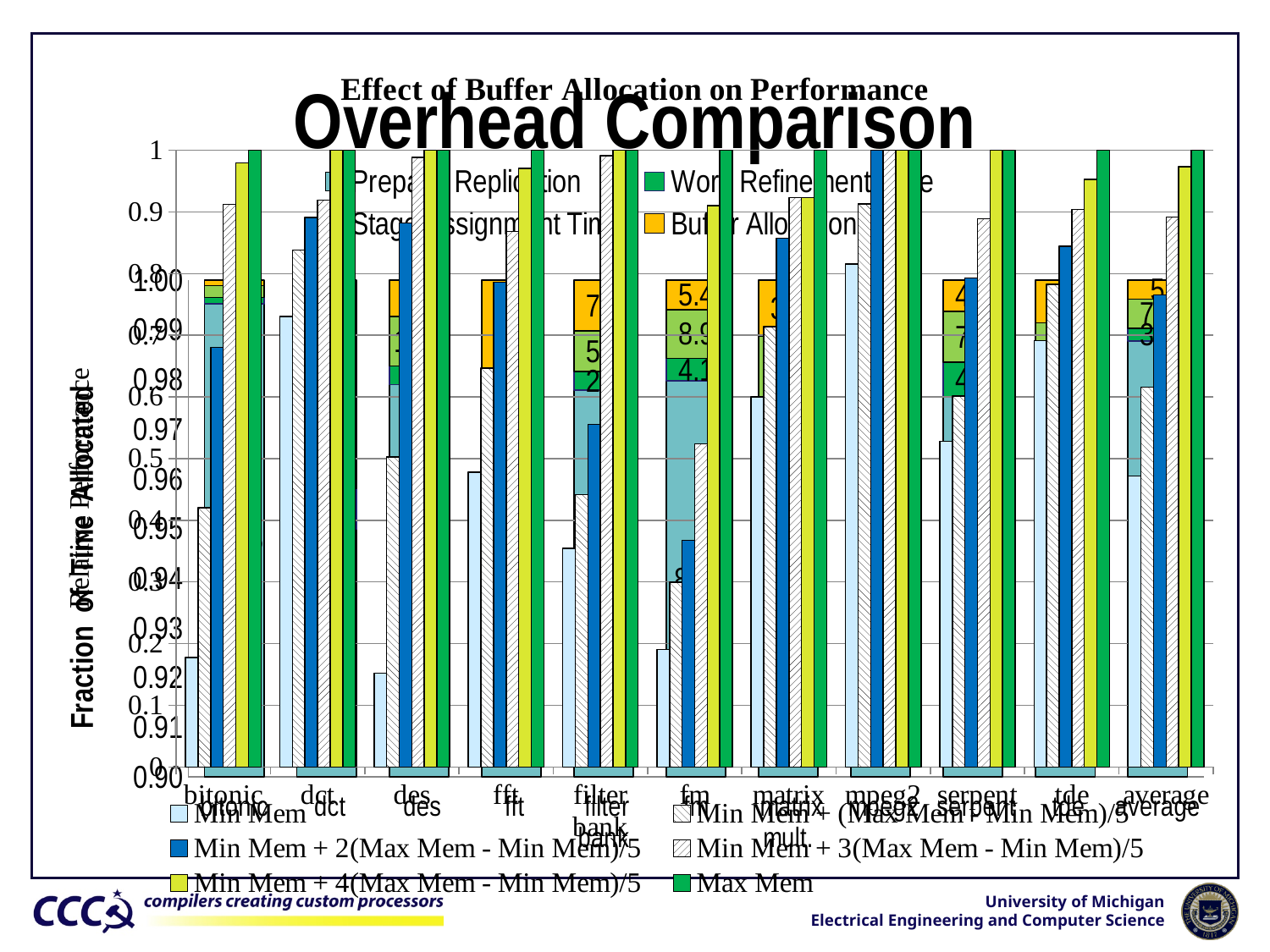
What kind of chart is the 'Effect of Buffer Allocation on Performance' chart? bar chart In the 'Effect of Buffer Allocation on Performance' chart, what is the Max Mem value for bitonic? 1 How many series does the legend of the 'Overhead Comparison' chart list? 4 In the 'Effect of Buffer Allocation on Performance' chart, is the Min Mem value for des greater or less than 0.2? less In the 'Effect of Buffer Allocation on Performance' chart, is the Min Mem value for mpeg2 greater or less than 0.7? greater What kind of chart is the 'Overhead Comparison' chart? stacked bar chart How many categories are shown along the x axis of the 'Effect of Buffer Allocation on Performance' chart? 11 In the 'Overhead Comparison' chart, which series is shown in yellow/orange? Buffer Allocation Time In the 'Effect of Buffer Allocation on Performance' chart, which is larger: the Min Mem value for mpeg2 or the Min Mem value for bitonic? mpeg2 In the 'Effect of Buffer Allocation on Performance' chart, is the Min Mem value for bitonic greater or less than 0.2? less How many series does the legend of the 'Effect of Buffer Allocation on Performance' chart list? 6